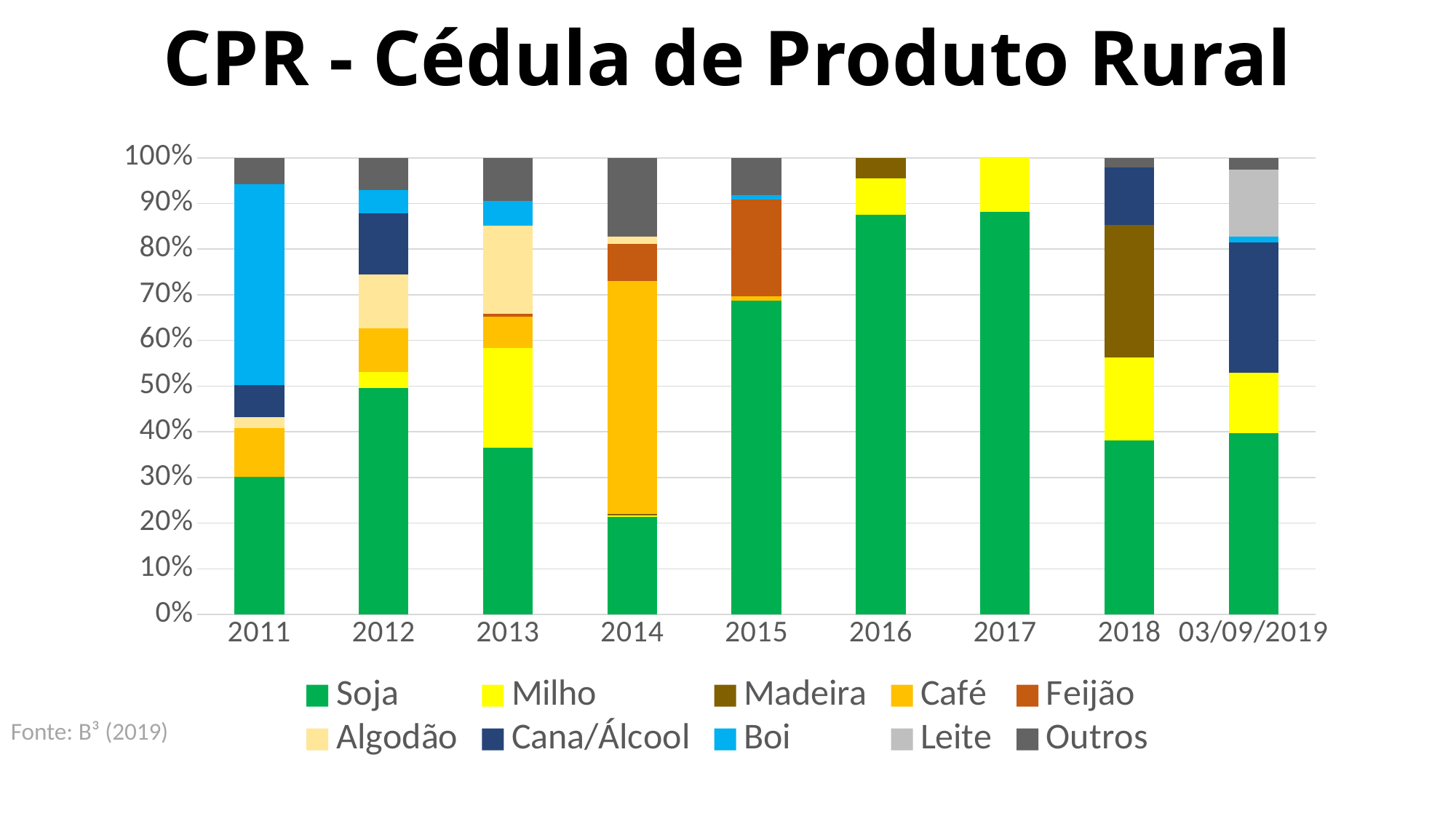
Is the share for Soja in 2013 greater or less than 40%? less Is the share for Soja in 2015 greater or less than 60%? greater What kind of chart is shown on the slide? Stacked bar chart Which year has the largest share for Café? 2014 Is the share for Soja in 2014 greater or less than 30%? less Which year has the smallest share for Soja? 2014 How many series does the legend list? 10 Which year has the largest share for Boi? 2011 Which year has the largest share for Madeira? 2018 What is the title of the chart? CPR - Cédula de Produto Rural Which is larger, the share for Soja in 2014 or the share for Soja in 2015? 2015 How many years (categories) are shown on the x axis? 9